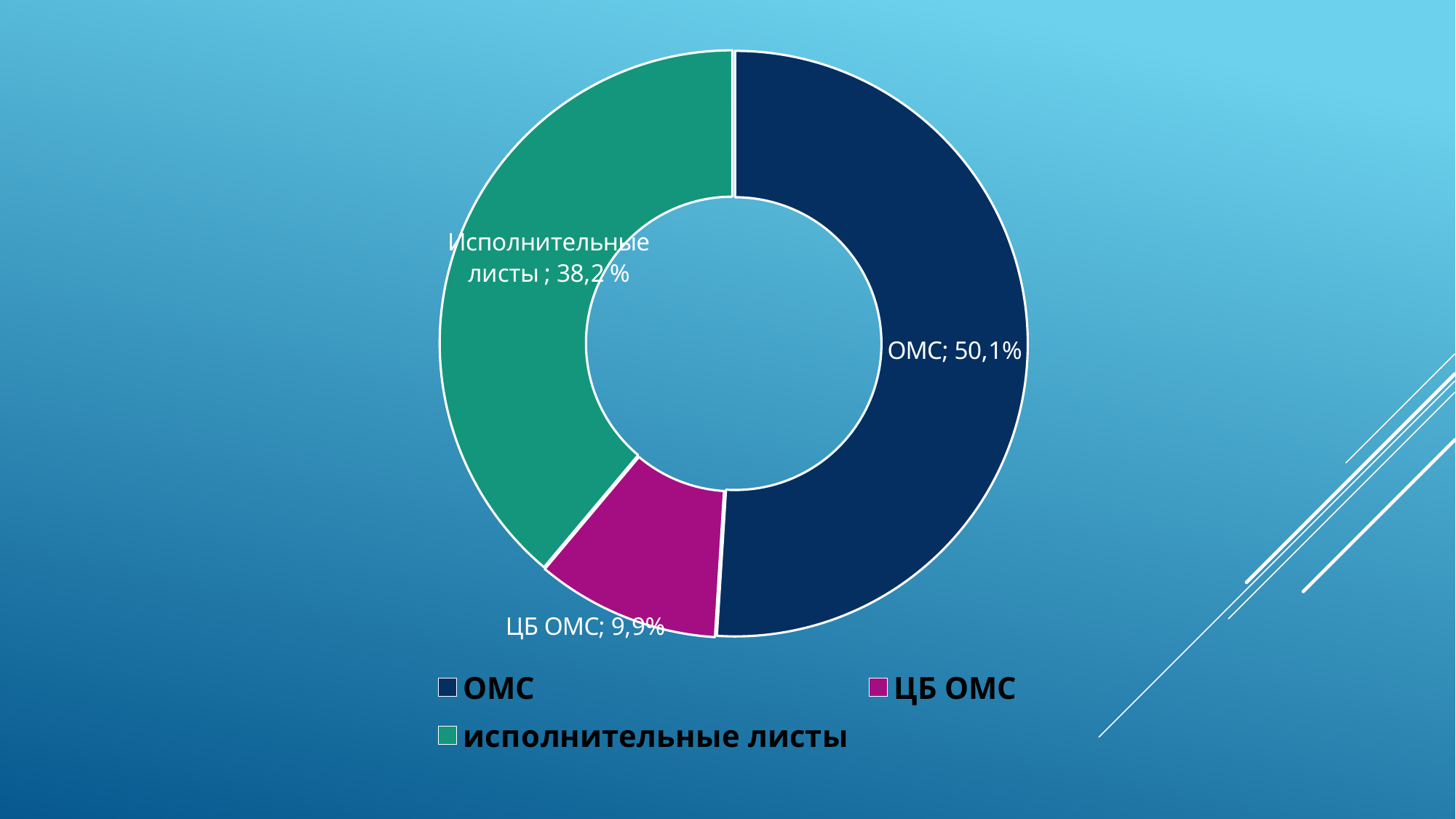
What share of the doughnut chart does ЦБ ОМС account for? 9,9% What is the difference in percentage points between the Исполнительные листы share and the ЦБ ОМС share? 28,3 What share of the doughnut chart does ОМС account for? 50,1% Which category has the largest share in the chart? ОМС What colour is the ЦБ ОМС segment in the chart? Magenta (purple) What is the difference in percentage points between the ОМС share and the Исполнительные листы share? 11,9 Which is larger: the share for ЦБ ОМС or the share for Исполнительные листы? Исполнительные листы What kind of chart is shown on the slide? Doughnut (pie) chart Which is larger: the share for ОМС or the share for Исполнительные листы? ОМС How many categories are shown in the chart? 3 Which category has the smallest share in the chart? ЦБ ОМС What share of the doughnut chart do Исполнительные листы account for? 38,2 %